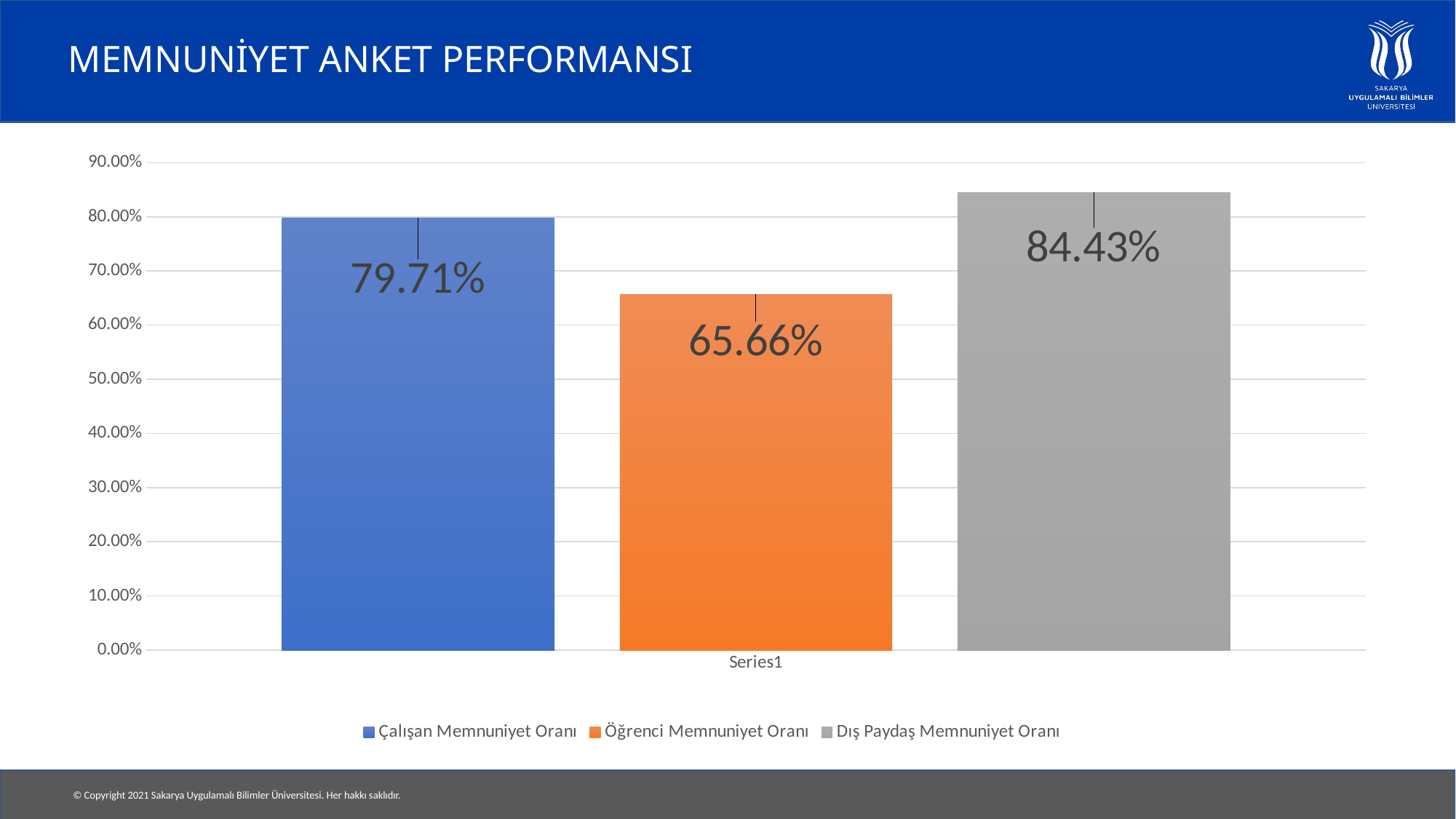
What is the value for Dış Paydaş Memnuniyet Oranı? 84.43% Which series has the lowest value? Öğrenci Memnuniyet Oranı What is the value for Çalışan Memnuniyet Oranı? 79.71% What is the difference between Dış Paydaş Memnuniyet Oranı and Öğrenci Memnuniyet Oranı? 18.77% Is the value for Öğrenci Memnuniyet Oranı greater or less than 70.00%? less How many series does the legend list? 3 Which series has the highest value? Dış Paydaş Memnuniyet Oranı What colour is the bar for Öğrenci Memnuniyet Oranı? Orange What kind of chart is shown on the slide? Bar chart What is the value for Öğrenci Memnuniyet Oranı? 65.66% Which is larger, Çalışan Memnuniyet Oranı or Dış Paydaş Memnuniyet Oranı? Dış Paydaş Memnuniyet Oranı What is the difference between Çalışan Memnuniyet Oranı and Öğrenci Memnuniyet Oranı? 14.05%